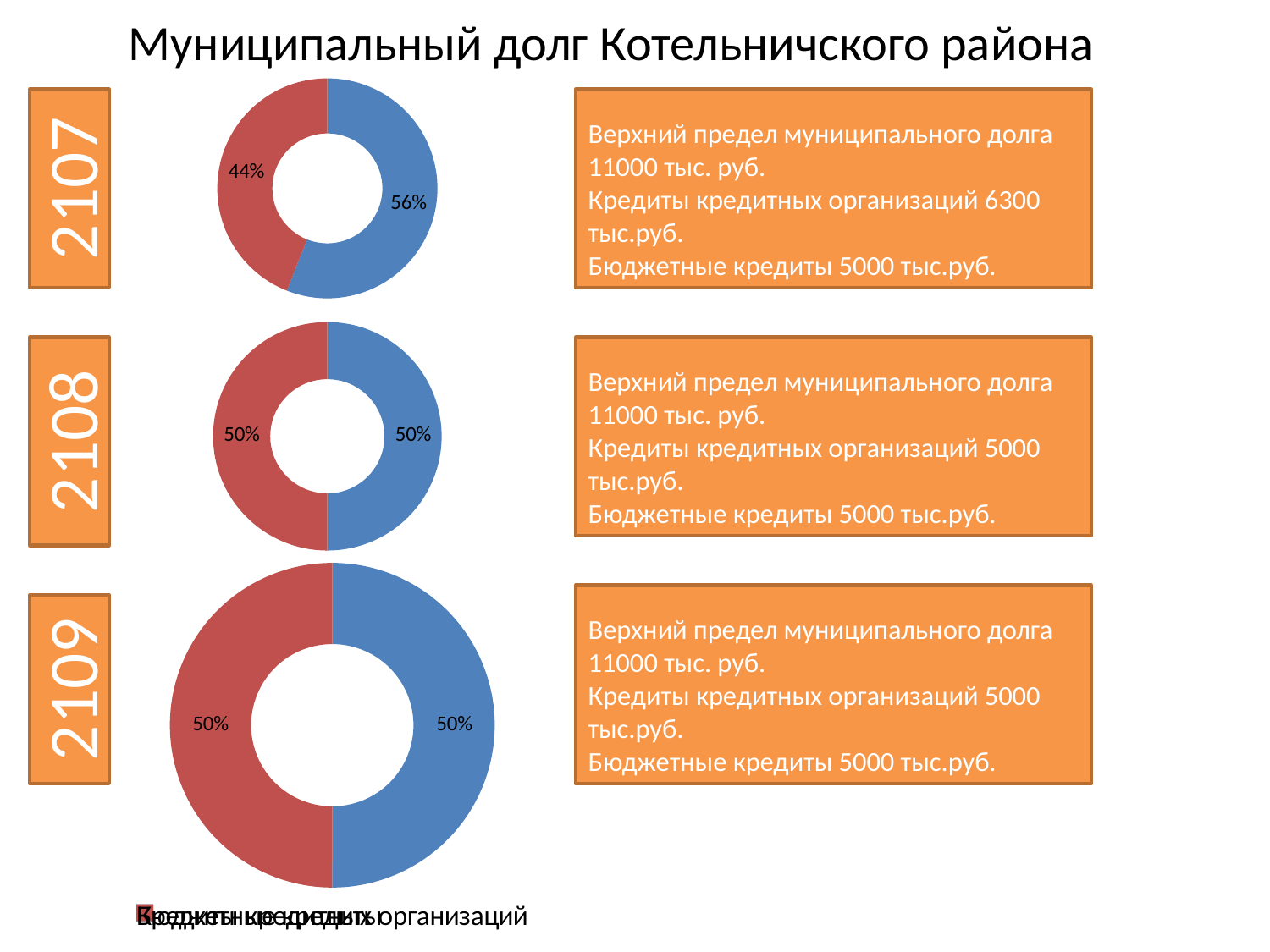
What kind of chart is used for the 2107 chart on the slide? doughnut chart In the 2107 chart, what is the difference in percentage points between the blue slice and the red slice? 12 In the 2107 chart, which slice is larger, the blue one or the red one? the blue one In the 2107 chart, what percentage is shown for the blue slice? 56% How many doughnut charts are shown on the slide? 3 In the 2108 chart, what percentage is shown for the red slice? 50% What is the title of the slide containing the charts? Муниципальный долг Котельничского района In the 2108 chart, what percentage is shown for the blue slice? 50% In the 2107 chart, what percentage is shown for the red slice? 44% In the 2109 chart, what percentage is shown for the blue slice? 50% How many slices does the 2109 chart have? 2 In the 2109 chart, what percentage is shown for the red slice? 50%